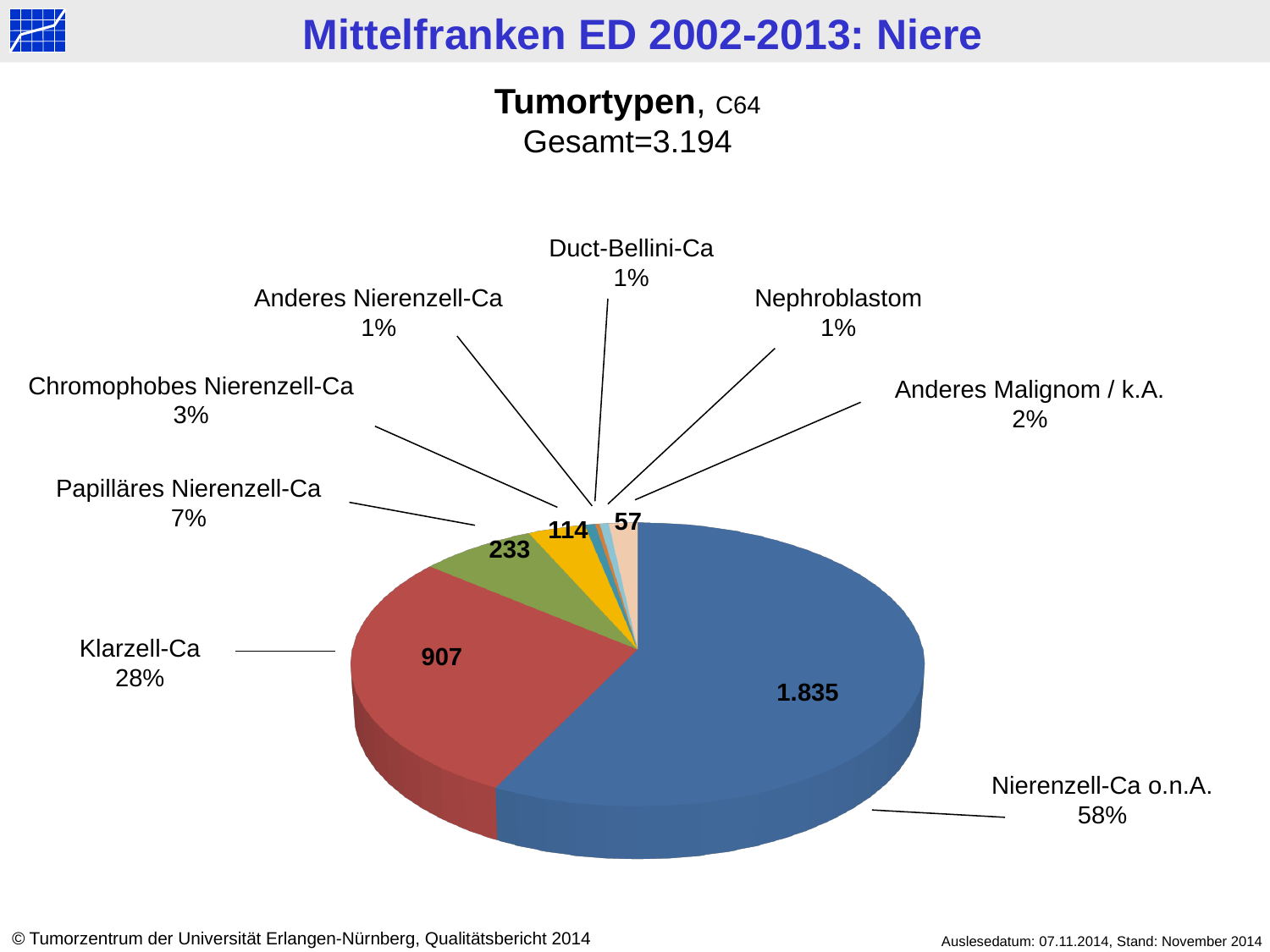
What total number of cases (Gesamt) is stated above the chart? 3.194 How many tumour type categories does the pie chart show? 8 What is the difference in cases between Nierenzell-Ca o.n.A. and Klarzell-Ca? 928 What kind of chart is shown on the slide? pie chart What is the number of cases shown for Klarzell-Ca? 907 What share of the pie does Klarzell-Ca account for? 28% What share of the pie does Anderes Malignom / k.A. account for? 2% What is the number of cases shown for Nierenzell-Ca o.n.A.? 1.835 What is the number of cases shown for Papilläres Nierenzell-Ca? 233 What is the number of cases shown for Chromophobes Nierenzell-Ca? 114 Which has more cases, Papilläres Nierenzell-Ca or Chromophobes Nierenzell-Ca? Papilläres Nierenzell-Ca Which tumour type has the largest slice of the pie? Nierenzell-Ca o.n.A.